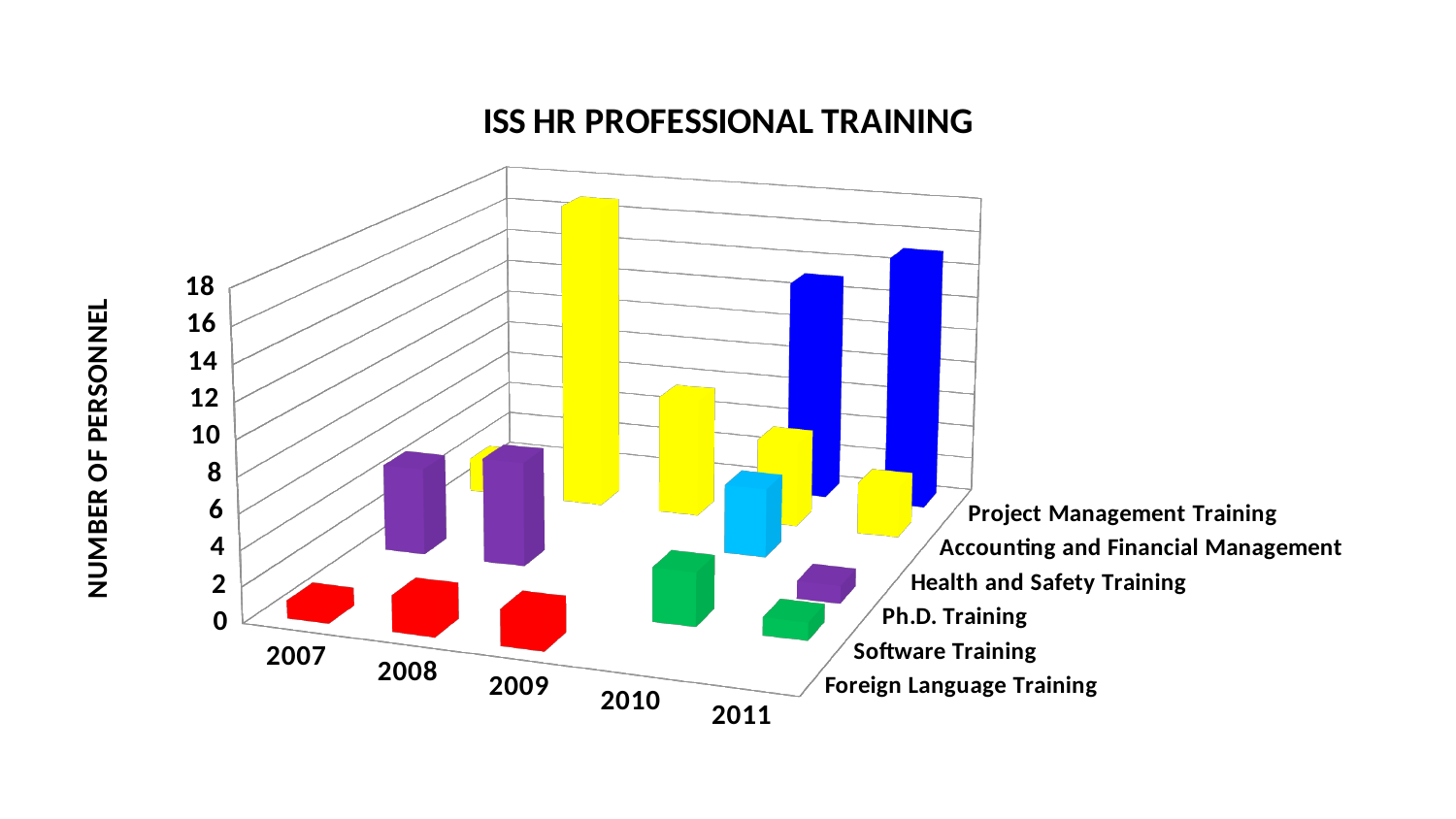
What is the highest value shown on the vertical axis? 18 Is the value for Foreign Language Training in 2007 greater or less than 4? less What kind of chart is shown on the slide? bar chart Which is the first year shown on the x axis? 2007 How many training types (series) are listed on the chart? 6 Which year has the tallest bar in the chart? 2008 What is the title of the chart? ISS HR PROFESSIONAL TRAINING What is the label of the vertical axis? NUMBER OF PERSONNEL Which is larger: the Accounting and Financial Management bar in 2009 or the Foreign Language Training bar in 2009? Accounting and Financial Management Is the value for Project Management Training in 2011 greater or less than 8? greater How many years are shown along the x axis of the chart? 5